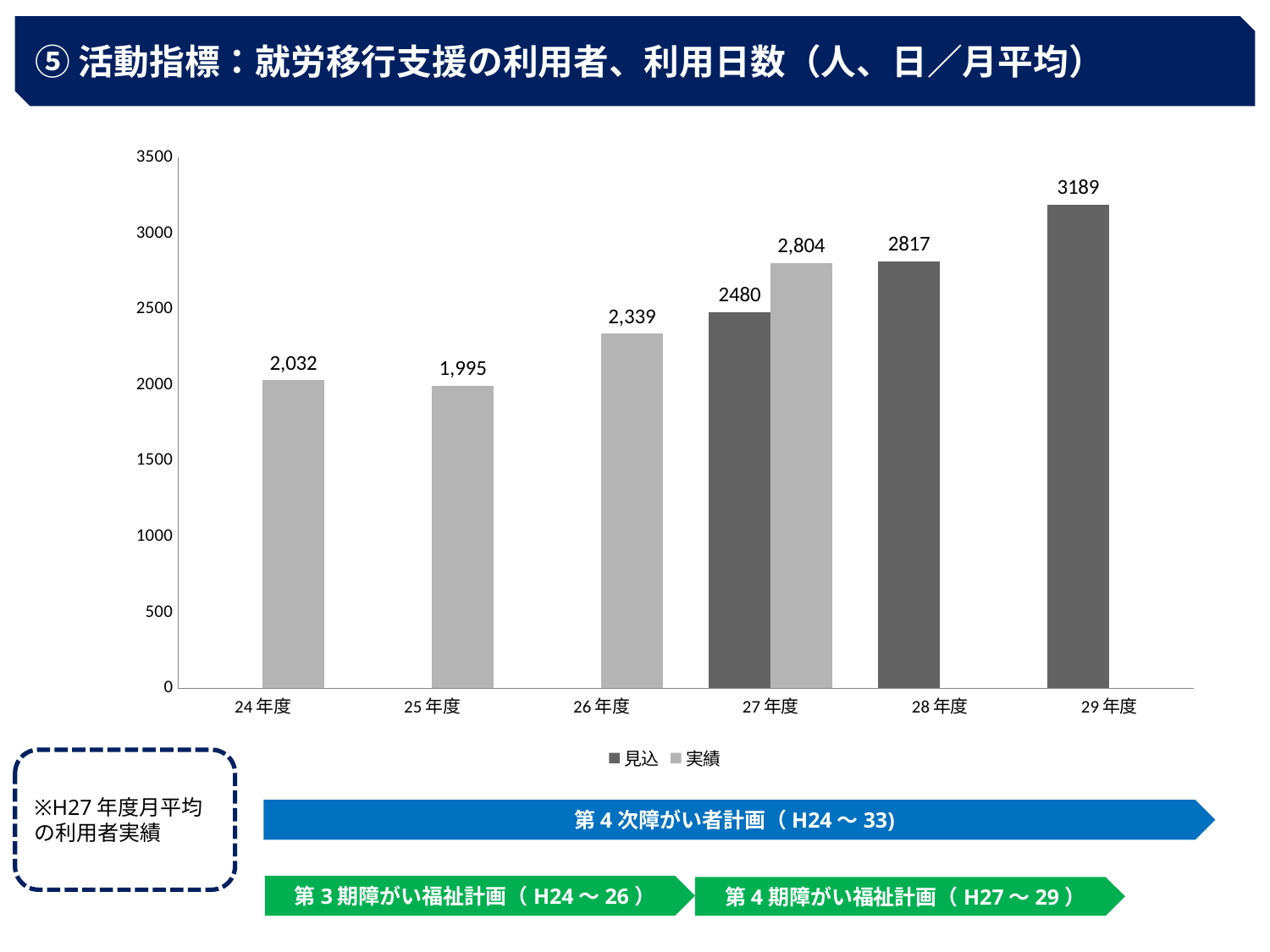
How many fiscal year categories are shown on the x axis? 6 Which is larger for 27年度, the 見込 value or the 実績 value? 実績 Which fiscal year has the lowest 実績 value? 25年度 Which fiscal year has the highest bar in the chart? 29年度 What is the difference between the 実績 and 見込 values for 27年度? 324 What is the 実績 value for 25年度? 1,995 What type of chart is shown on the slide? bar chart What is the 見込 value for 29年度? 3189 What is the 実績 value for 24年度? 2,032 What is the 見込 value for 27年度? 2480 Do the 見込 values rise or fall from 27年度 to 29年度? rise How many series does the legend list? 2